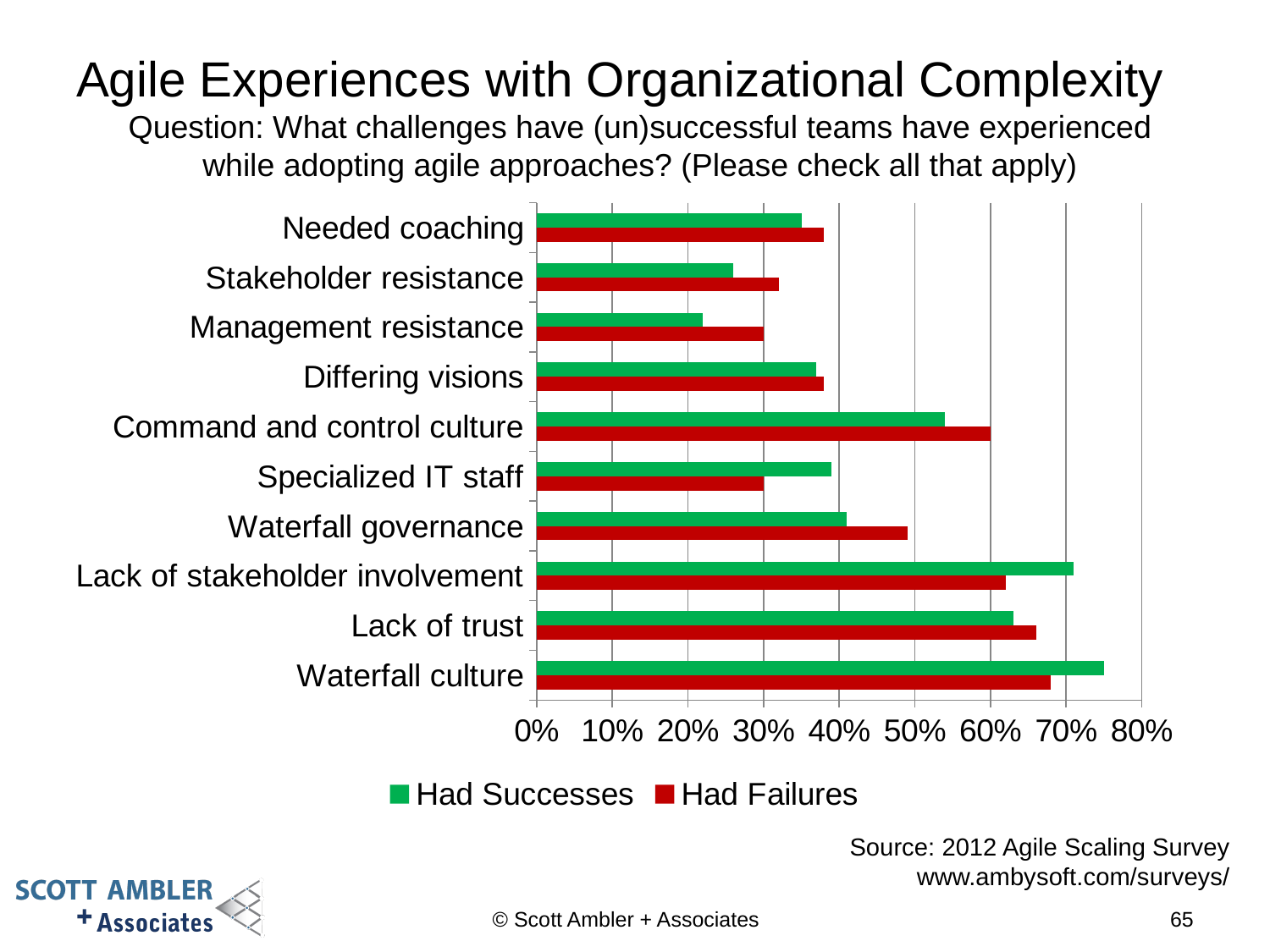
For Specialized IT staff, which series has the larger value, Had Successes or Had Failures? Had Successes Which category has the lowest value for Had Successes? Management resistance How many challenge categories are plotted on the chart? 10 Which category has the highest value for Had Successes? Waterfall culture What kind of chart is shown on the slide? bar chart Which colour represents the Had Successes series in the legend? green Is the Had Failures value for Command and control culture greater or less than 50%? greater Is the Had Successes value for Waterfall culture greater or less than 70%? greater How many series does the legend list? 2 Is the Had Failures value for Specialized IT staff greater or less than 40%? less For Waterfall governance, which series has the larger value, Had Successes or Had Failures? Had Failures